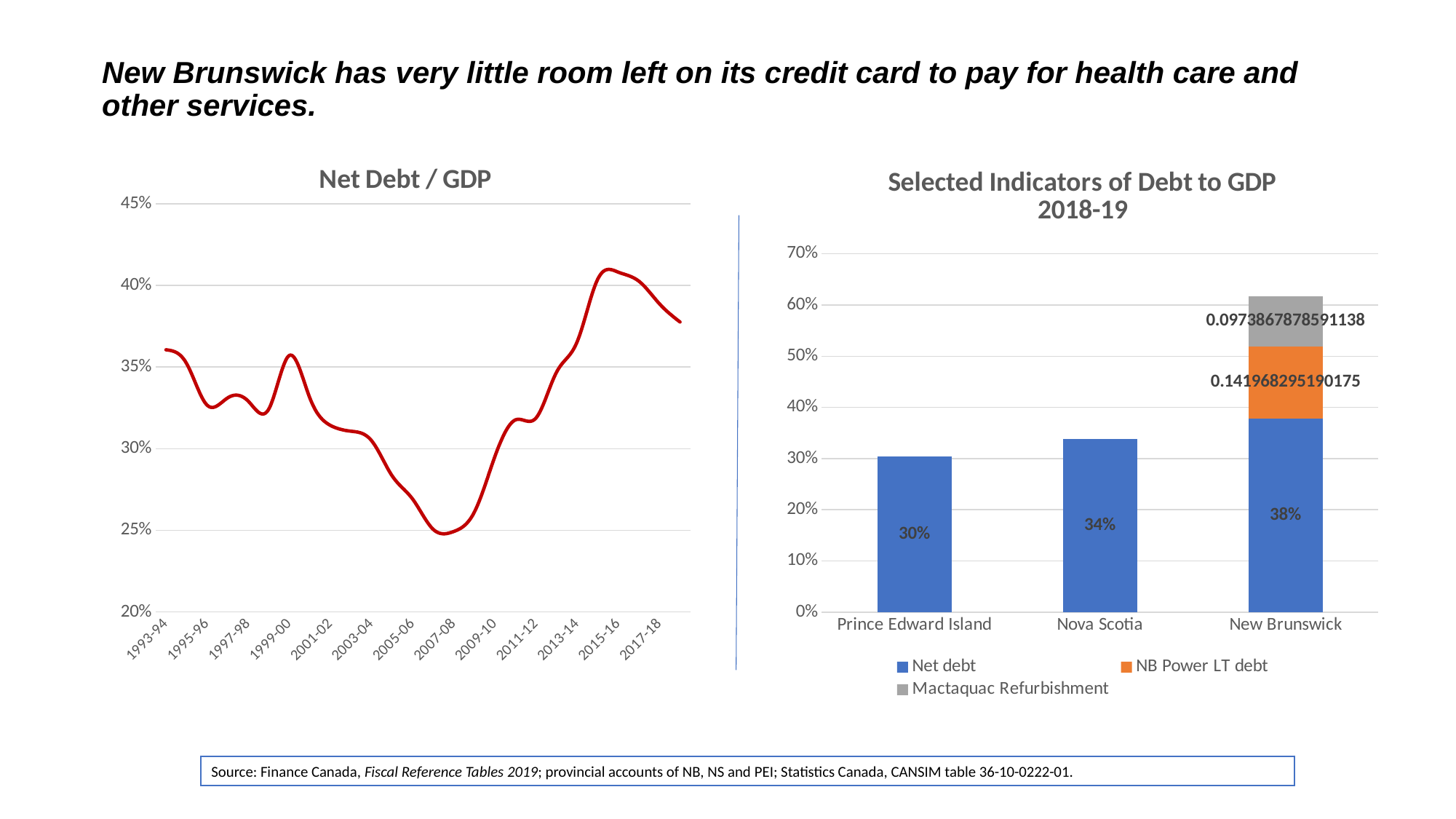
What kind of chart is the 'Selected Indicators of Debt to GDP 2018-19' chart on the right? bar chart In the 'Selected Indicators of Debt to GDP 2018-19' chart, which province has the lowest Net debt? Prince Edward Island How many series does the legend of the 'Selected Indicators of Debt to GDP 2018-19' chart list? 3 In the 'Net Debt / GDP' chart, is the value for 2015-16 greater or less than 40%? greater In the 'Selected Indicators of Debt to GDP 2018-19' chart, what is the Net debt value for New Brunswick? 38% In the 'Selected Indicators of Debt to GDP 2018-19' chart, what is the Net debt value for Nova Scotia? 34% What kind of chart is the 'Net Debt / GDP' chart on the left? line chart In the 'Selected Indicators of Debt to GDP 2018-19' chart, which province has the highest Net debt? New Brunswick In the 'Selected Indicators of Debt to GDP 2018-19' chart, what is the difference between the Net debt of Nova Scotia and Prince Edward Island? 4% In the 'Net Debt / GDP' chart, does the line rise or fall from 2015-16 to 2017-18? fall In the 'Selected Indicators of Debt to GDP 2018-19' chart, what is the data label shown for the NB Power LT debt segment of New Brunswick? 0.141968295190175 In the 'Selected Indicators of Debt to GDP 2018-19' chart, what is the Net debt value for Prince Edward Island? 30%